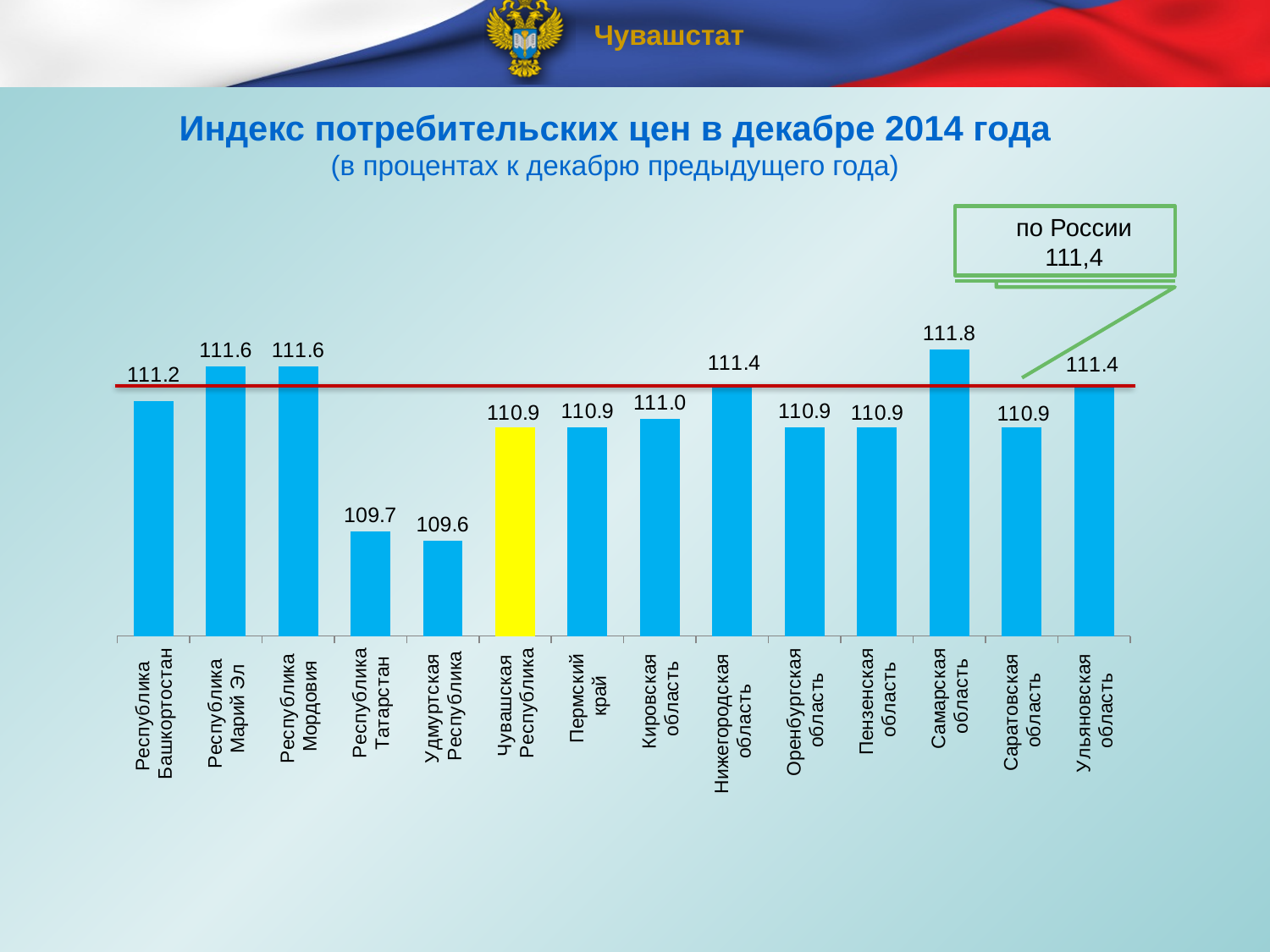
Which region has the highest value on the chart? Самарская область What is the value shown for Нижегородская область? 111.4 What is the consumer price index value for Чувашская Республика? 110.9 What is the difference between the values for Самарская область and Удмуртская Республика? 2.2 What is the value shown for Самарская область? 111.8 Which region has the lowest value on the chart? Удмуртская Республика What kind of chart is shown on the slide? Bar chart Which region's bar is highlighted in yellow? Чувашская Республика What is the value shown for Республика Татарстан? 109.7 How many regions are shown on the chart? 14 What value for Russia as a whole (по России) is shown in the callout box? 111,4 Which is larger, the value for Республика Башкортостан or the value for Кировская область? Республика Башкортостан